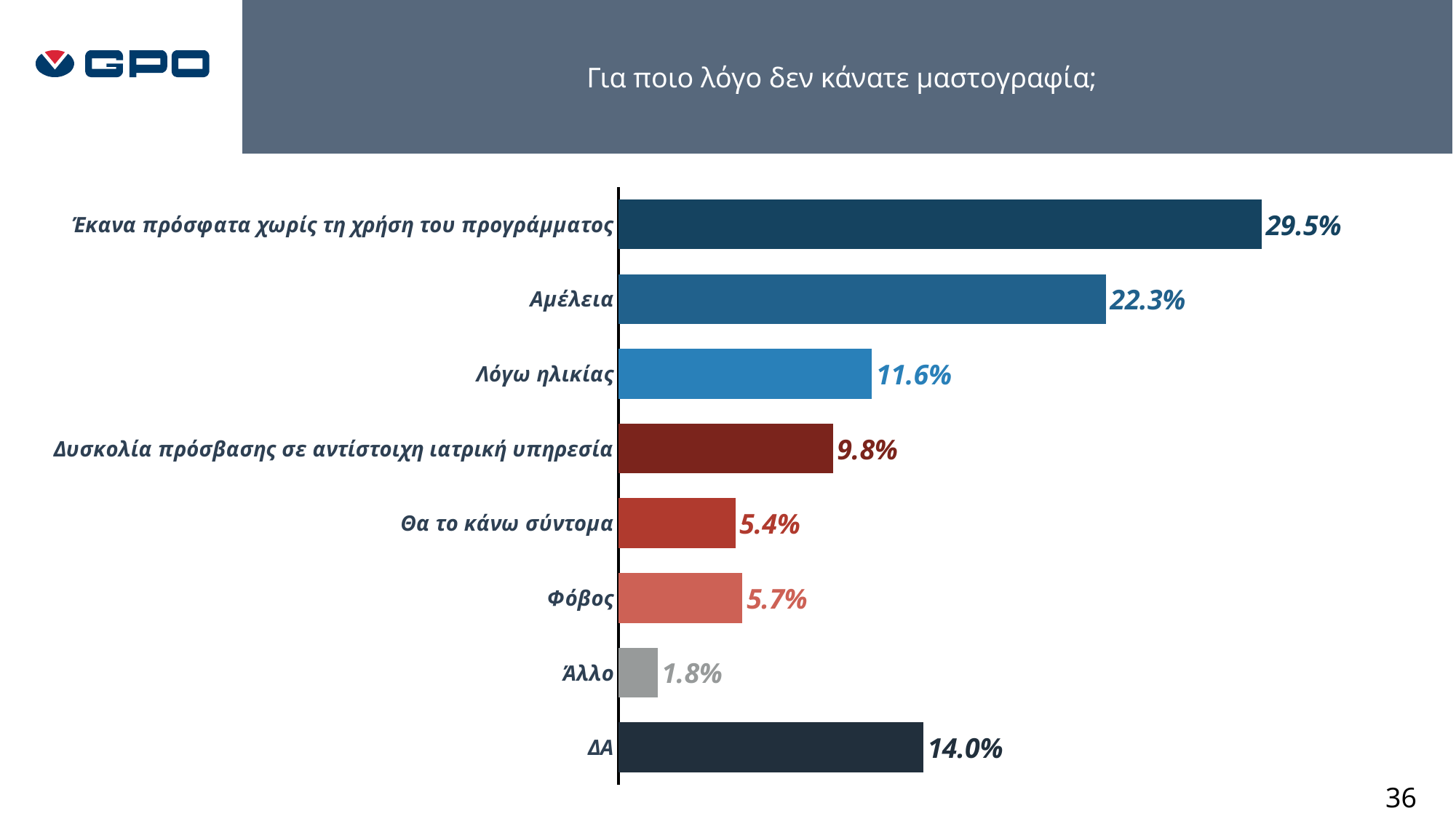
Which category has the highest value? Έκανα πρόσφατα χωρίς τη χρήση του προγράμματος What is the value for Λόγω ηλικίας? 11.6% What kind of chart is shown on the slide? Bar chart What is the value for Φόβος? 5.7% What is the difference between the values for Έκανα πρόσφατα χωρίς τη χρήση του προγράμματος and Αμέλεια? 7.2% How many categories are shown in the chart? 8 What is the difference between the values for ΔΑ and Δυσκολία πρόσβασης σε αντίστοιχη ιατρική υπηρεσία? 4.2% What is the value for ΔΑ? 14.0% What is the title of the chart? Για ποιο λόγο δεν κάνατε μαστογραφία; What is the value for Αμέλεια? 22.3% Which category has the lowest value? Άλλο Which is larger, the value for Λόγω ηλικίας or the value for ΔΑ? ΔΑ